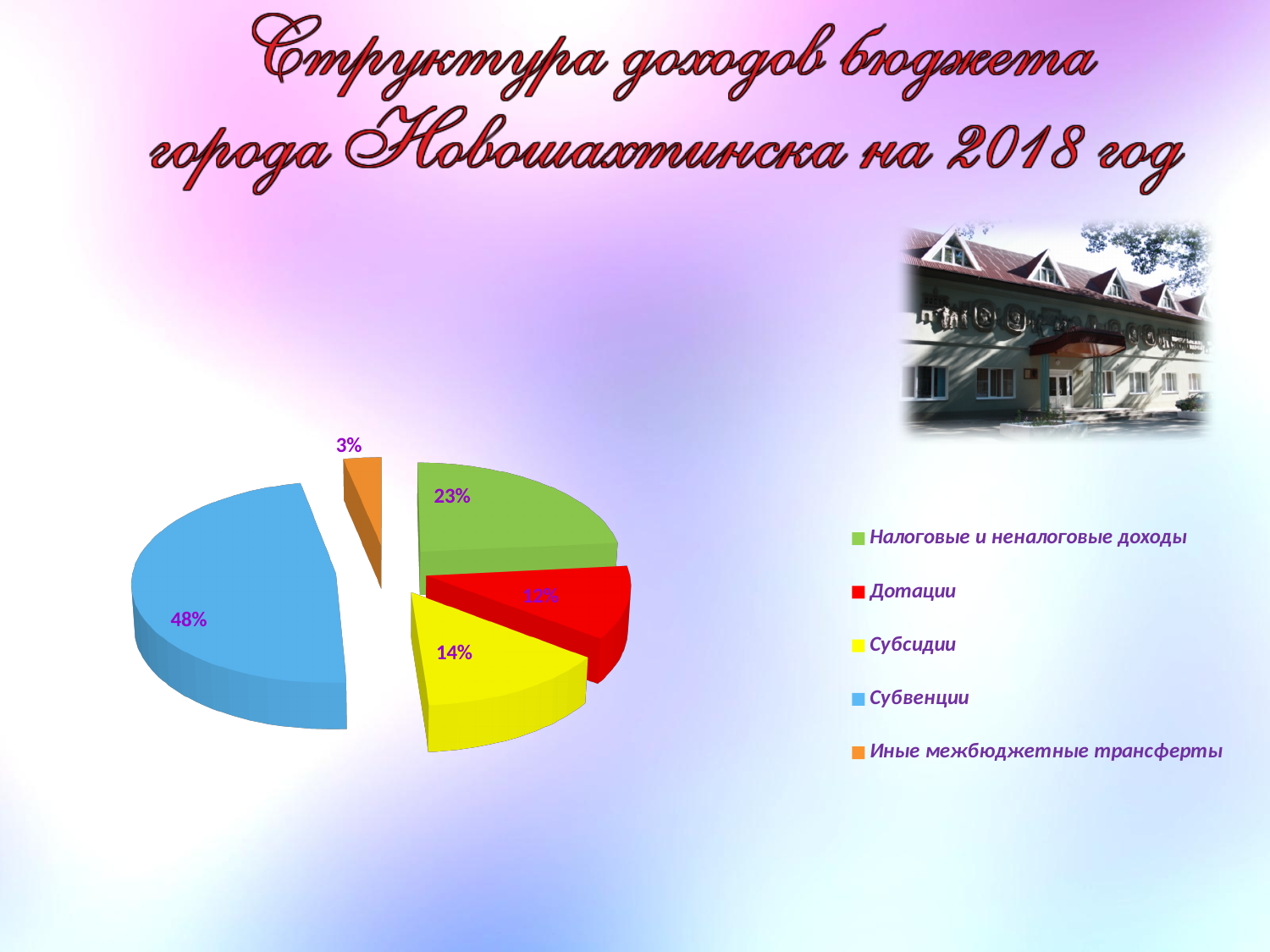
Which category has the largest slice of the pie? Субвенции What share of the pie does Налоговые и неналоговые доходы have? 23% What share of the pie does Дотации have? 12% Which is larger, the share for Субсидии or the share for Дотации? Субсидии What share of the pie does Субвенции have? 48% Which category has the smallest slice of the pie? Иные межбюджетные трансферты What kind of chart is shown on the slide? Pie chart What share of the pie does Иные межбюджетные трансферты have? 3% What share of the pie does Субсидии have? 14% What is the difference in percentage points between Субвенции and Налоговые и неналоговые доходы? 25 How many slices does the pie chart have? 5 What colour is the slice for Дотации? Red